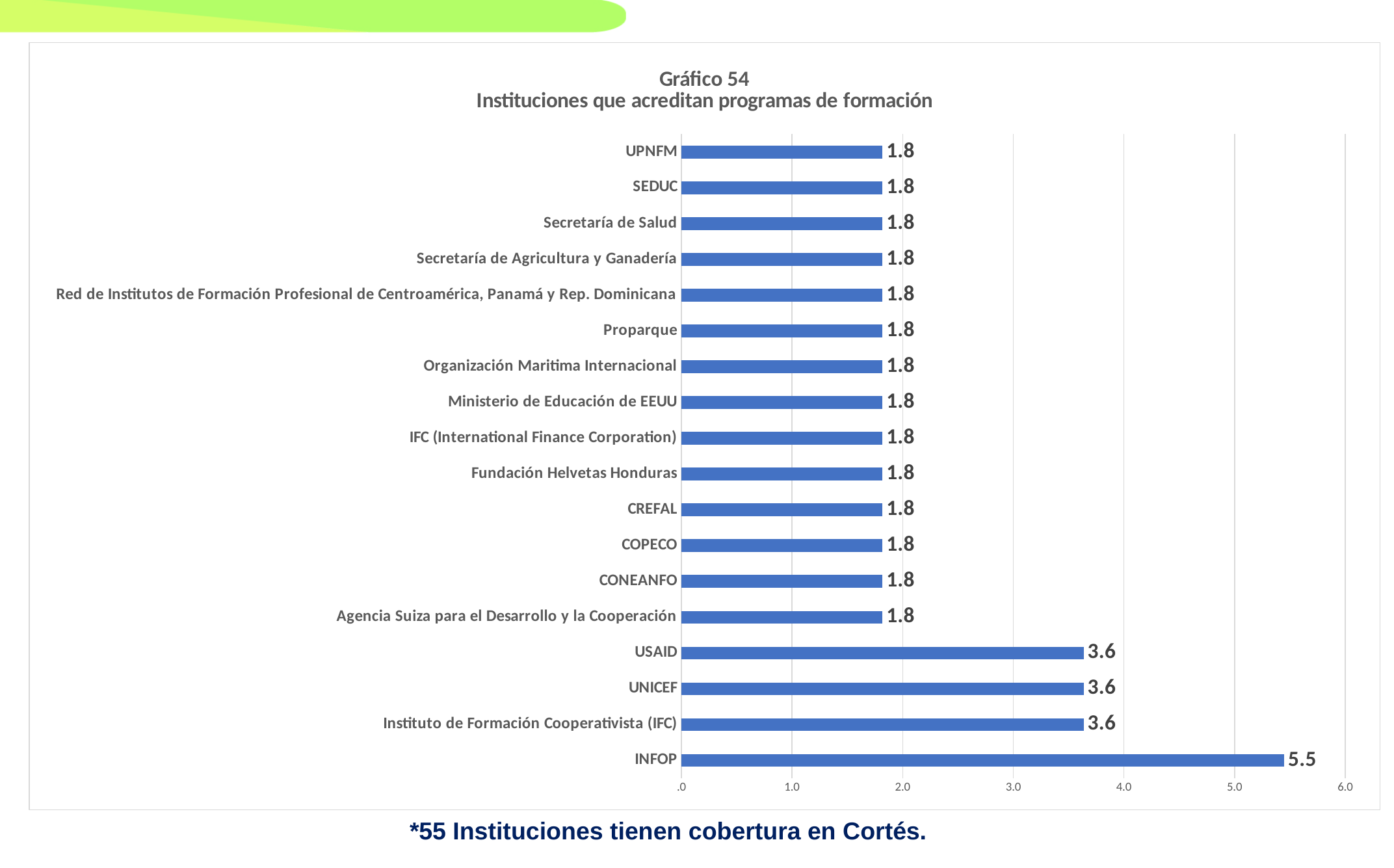
What is the title of the chart? Gráfico 54 Instituciones que acreditan programas de formación How many institutions are shown in the chart? 18 What is the value for Instituto de Formación Cooperativista (IFC)? 3.6 What is the value for Proparque? 1.8 Which institution has the highest value? INFOP What kind of chart is shown on the slide? bar chart Is the value for INFOP greater or less than 5.0? greater What is the difference between the values for USAID and COPECO? 1.8 Which is larger, the value for UNICEF or the value for CREFAL? UNICEF What is the value for INFOP? 5.5 What is the difference between the values for INFOP and UNICEF? 1.9 What is the value for USAID? 3.6